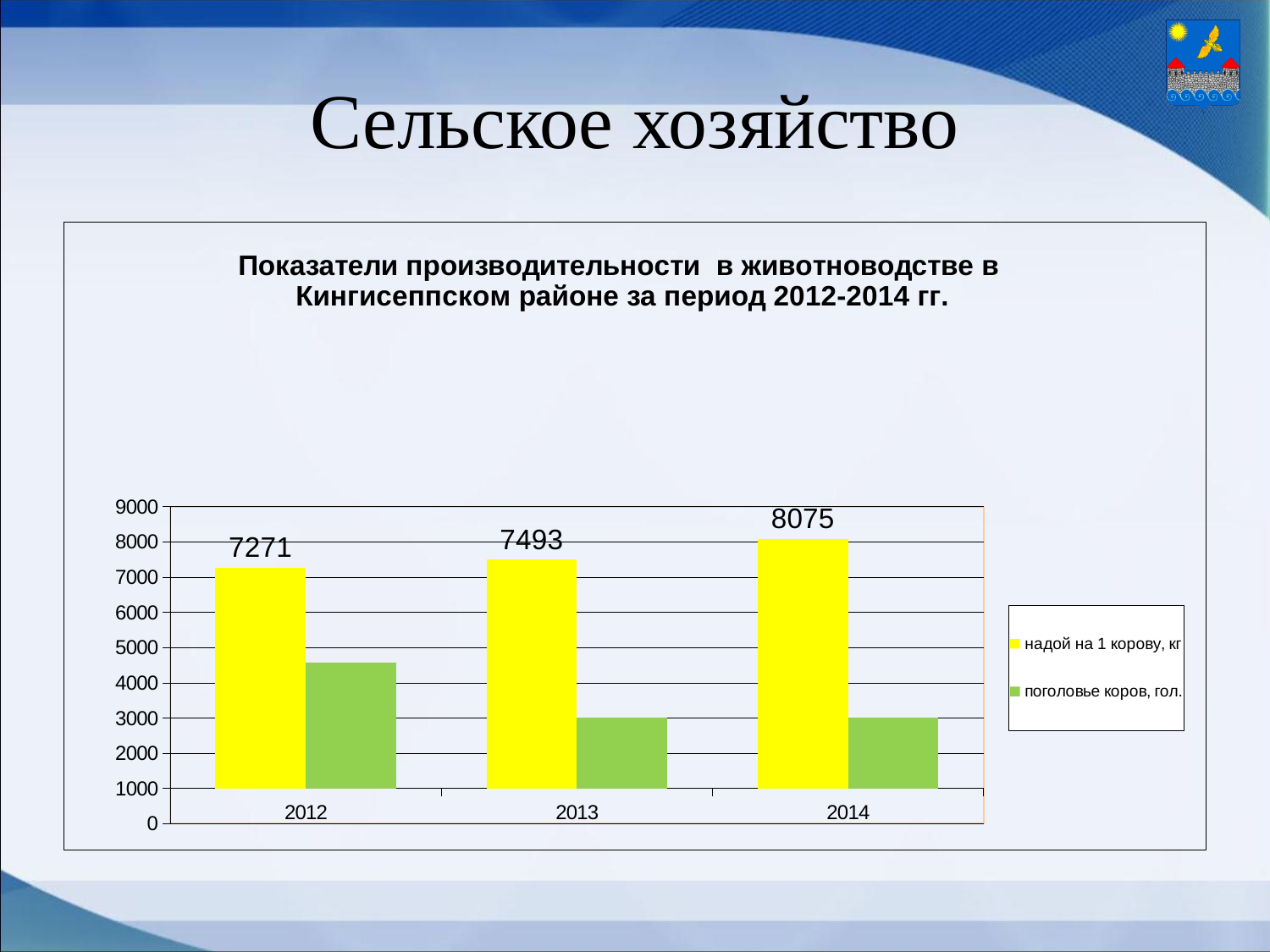
In which year is надой на 1 корову, кг the highest? 2014 What is the value of надой на 1 корову, кг for 2013? 7493 Does надой на 1 корову, кг rise or fall from 2012 to 2014? rise What is the value of надой на 1 корову, кг for 2014? 8075 What is the value of надой на 1 корову, кг for 2012? 7271 How many series does the legend list? 2 What is the difference in надой на 1 корову, кг between 2013 and 2012? 222 Is the value for поголовье коров, гол. in 2013 greater or less than 4000? less What kind of chart is shown on the slide? bar chart In which year is надой на 1 корову, кг the lowest? 2012 Is the value for поголовье коров, гол. in 2012 greater or less than 4000? greater By how much did надой на 1 корову, кг increase from 2012 to 2014? 804